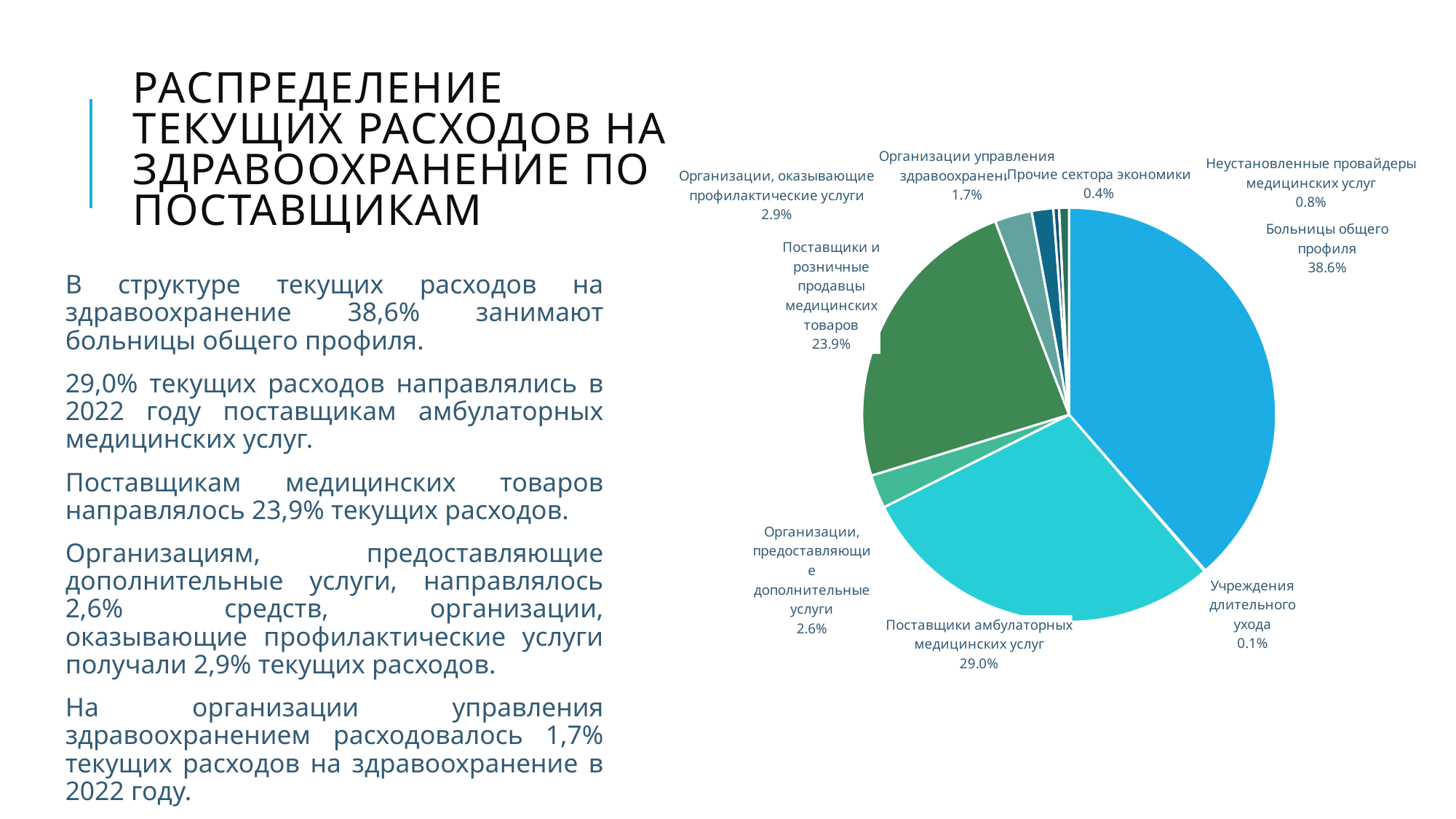
Какая доля приходится на поставщиков амбулаторных медицинских услуг? 29.0% Что больше: доля организаций, оказывающих профилактические услуги, или доля организаций, предоставляющих дополнительные услуги? Организации, оказывающие профилактические услуги Сколько категорий показано на круговой диаграмме? 9 Какая категория имеет наибольшую долю на диаграмме? Больницы общего профиля Какая доля приходится на прочие сектора экономики? 0.4% На сколько процентных пунктов доля больниц общего профиля больше доли поставщиков амбулаторных медицинских услуг? 9.6 Какая категория имеет наименьшую долю на диаграмме? Учреждения длительного ухода Какая доля приходится на поставщиков и розничных продавцов медицинских товаров? 23.9% Какой тип диаграммы показан на слайде? Круговая диаграмма Какая доля приходится на учреждения длительного ухода? 0.1% Какая доля приходится на организации управления здравоохранением? 1.7% Какую долю занимают больницы общего профиля на диаграмме? 38.6%